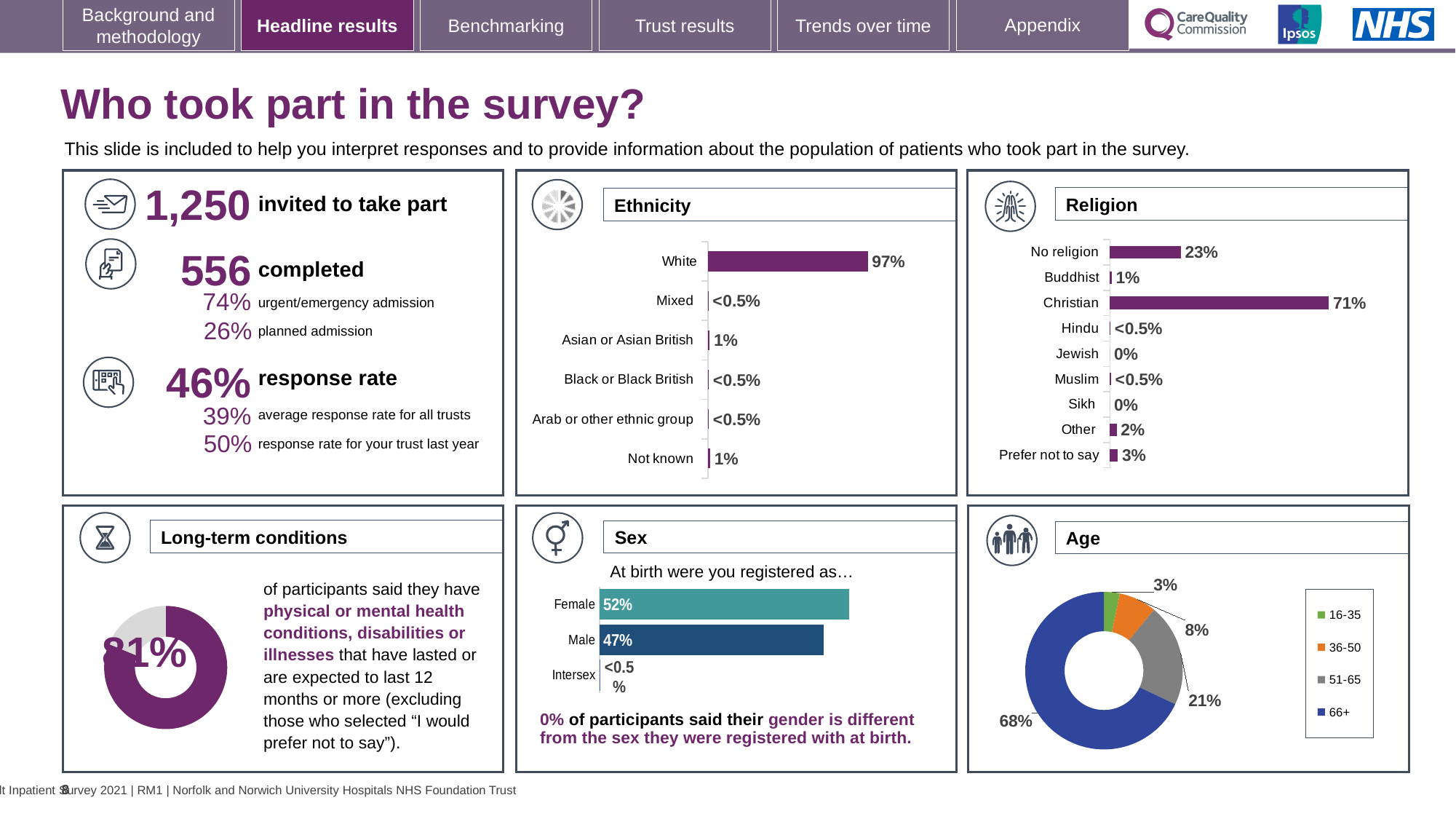
In the Religion chart, how many categories are shown? 9 In the Sex chart, what is the difference between the Female and Male values? 5% In the Sex chart, what percentage of participants were registered as Female at birth? 52% In the Age chart, what share of participants were aged 66+? 68% In the Age chart, how many age groups does the legend list? 4 In the Religion chart, what is the difference between the Christian and No religion values? 48% In the Religion chart, which religion category has the highest value? Christian In the Religion chart, what percentage of participants said they had no religion? 23% In the Ethnicity chart, what percentage of participants were White? 97% In the Ethnicity chart, how many ethnic categories are listed? 6 In the Sex chart, which is larger, the Female value or the Male value? Female What kind of chart is used in the Age panel? Doughnut chart